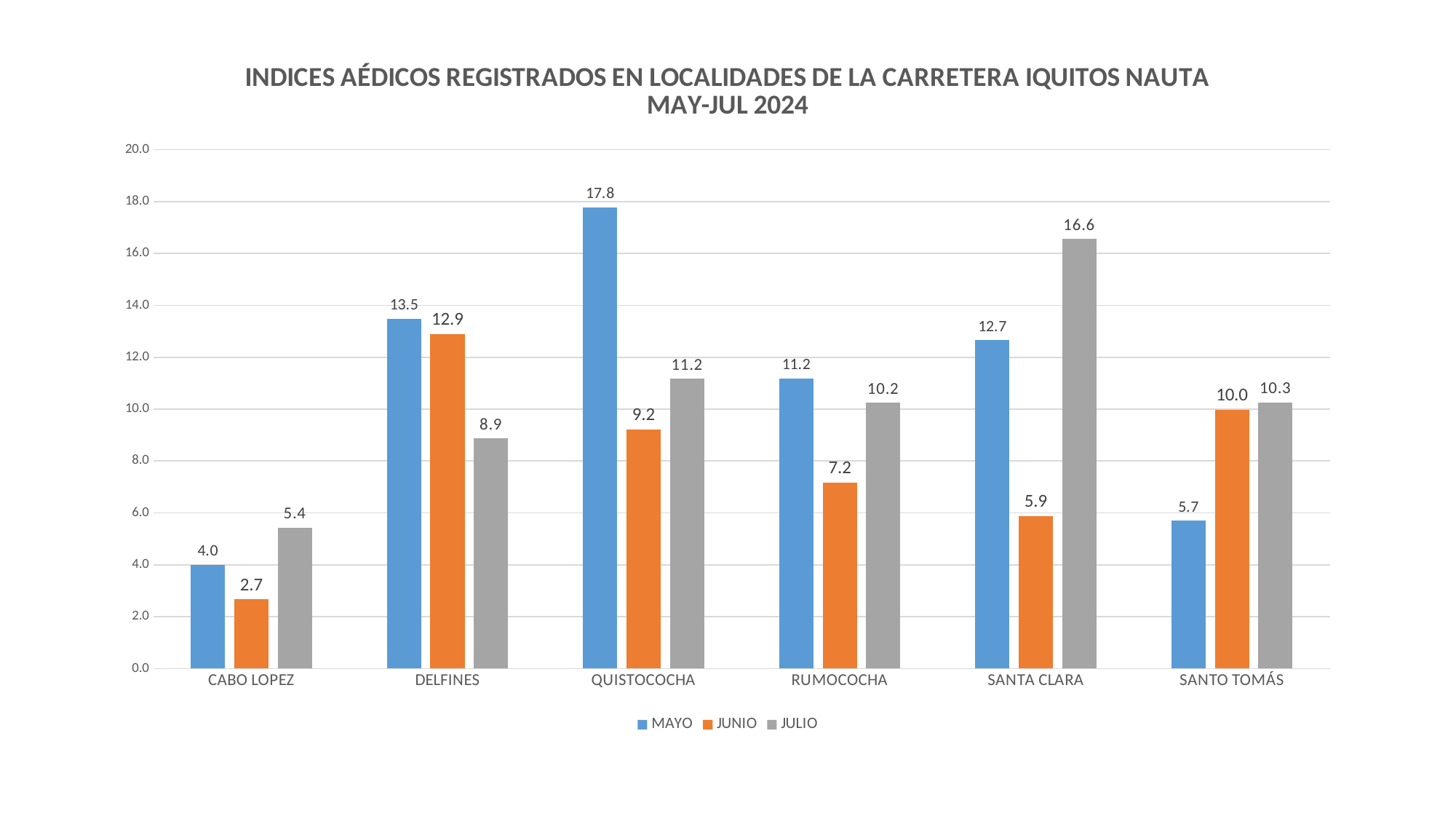
What is the JUNIO value for CABO LOPEZ? 2.7 Is the JULIO value for RUMOCOCHA greater or less than 8.0? greater What kind of chart is shown on the slide? Bar chart Which colour represents the JUNIO series? Orange How many series does the legend list? 3 Which locality has the lowest JUNIO value? CABO LOPEZ Which is larger for SANTO TOMÁS, the JUNIO value or the JULIO value? JULIO What is the MAYO value for QUISTOCOCHA? 17.8 Which locality has the highest MAYO value? QUISTOCOCHA What is the JULIO value for SANTA CLARA? 16.6 What is the difference between the MAYO and JULIO values for DELFINES? 4.6 How many localities are shown on the x axis? 6